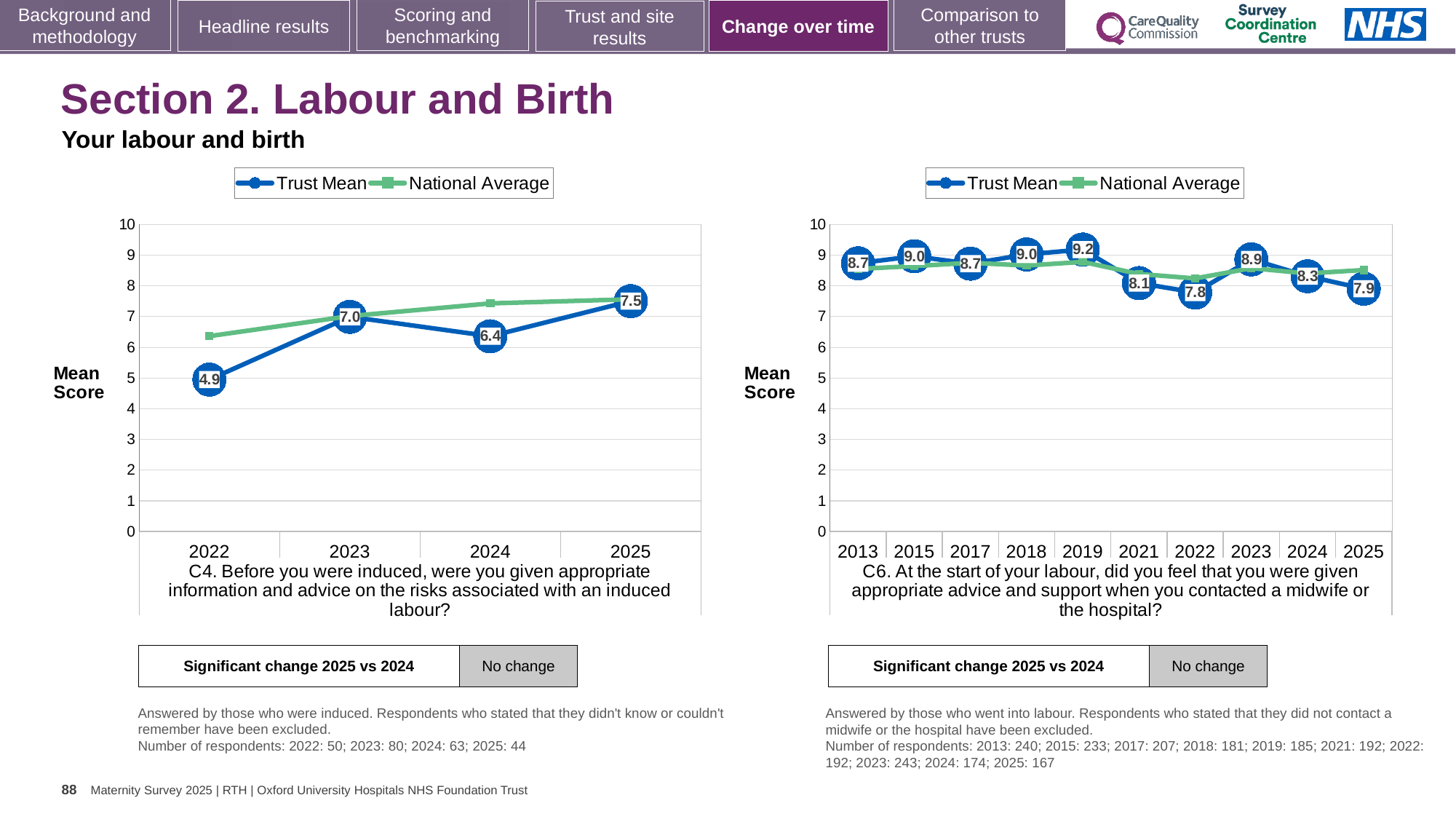
In the right chart (C6), how many series does the legend list? 2 What type of chart is the right chart (C6)? Line chart In the right chart (C6), which is larger, the Trust Mean for 2023 or the Trust Mean for 2024? 2023 In the left chart (C4), which year has the lowest Trust Mean score? 2022 In the left chart (C4), is the National Average for 2022 greater or less than 6? greater In the left chart (C4), how many years are shown on the x axis? 4 In the left chart (C4), what is the difference between the Trust Mean scores for 2023 and 2024? 0.6 In the left chart (C4), what is the Trust Mean score for 2022? 4.9 In the right chart (C6), which year has the highest Trust Mean score? 2019 In the right chart (C6), what is the Trust Mean score for 2019? 9.2 In the right chart (C6), what is the Trust Mean score for 2022? 7.8 In the left chart (C4), what is the Trust Mean score for 2025? 7.5